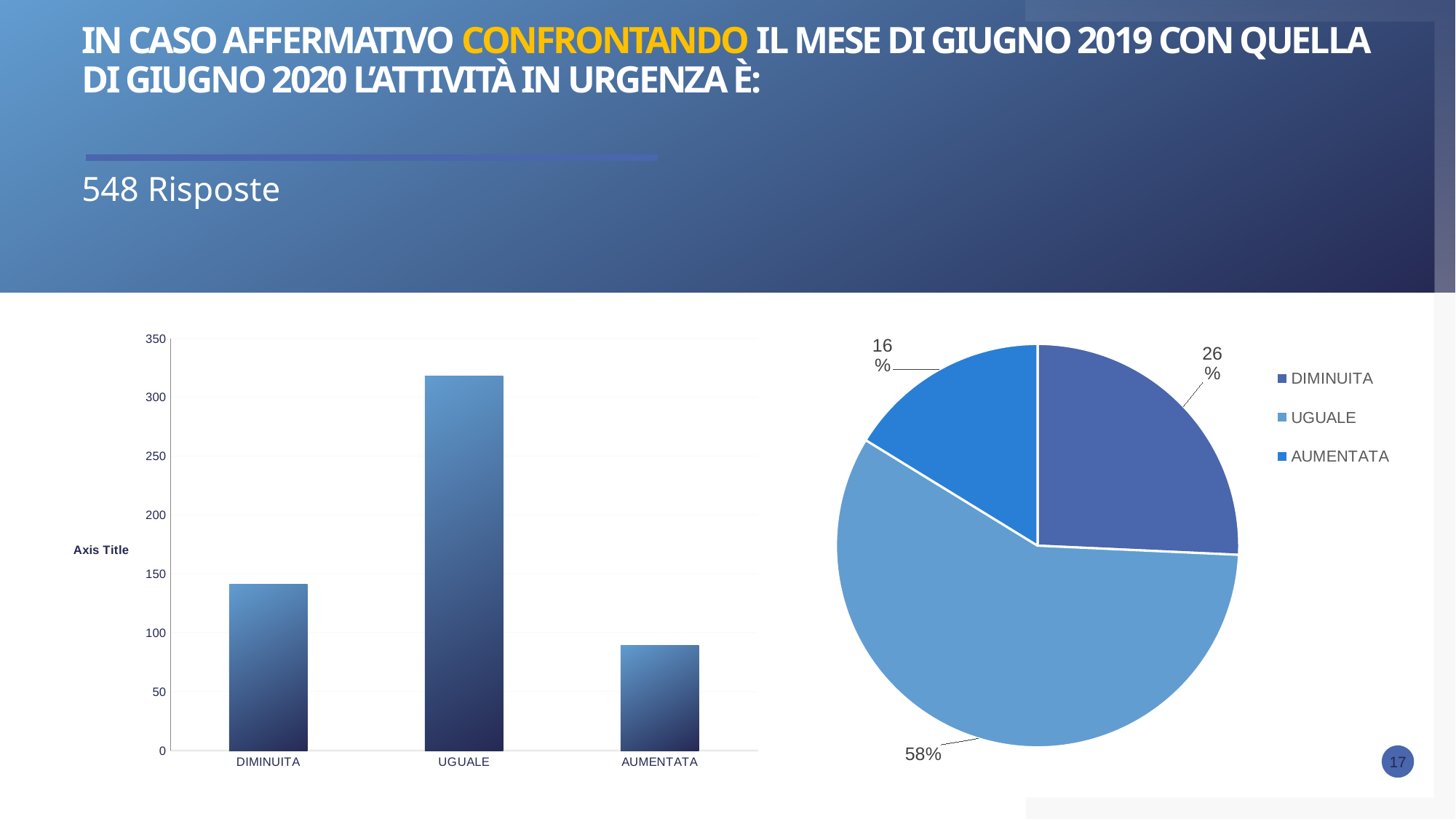
In the bar chart on the left, how many categories are shown? 3 In the pie chart on the right, what share does UGUALE have? 58% In the bar chart on the left, is the value for UGUALE greater or less than 300? greater What kind of chart is the chart on the right of the slide? pie chart In the bar chart on the left, is the value for AUMENTATA greater or less than 100? less In the pie chart on the right, how many entries does the legend list? 3 In the pie chart on the right, what share does DIMINUITA have? 26% In the pie chart on the right, what share does AUMENTATA have? 16% In the bar chart on the left, which category has the lowest value? AUMENTATA What kind of chart is the chart on the left of the slide? bar chart In the bar chart on the left, which category has the highest value? UGUALE In the bar chart on the left, is the value for DIMINUITA greater or less than 100? greater